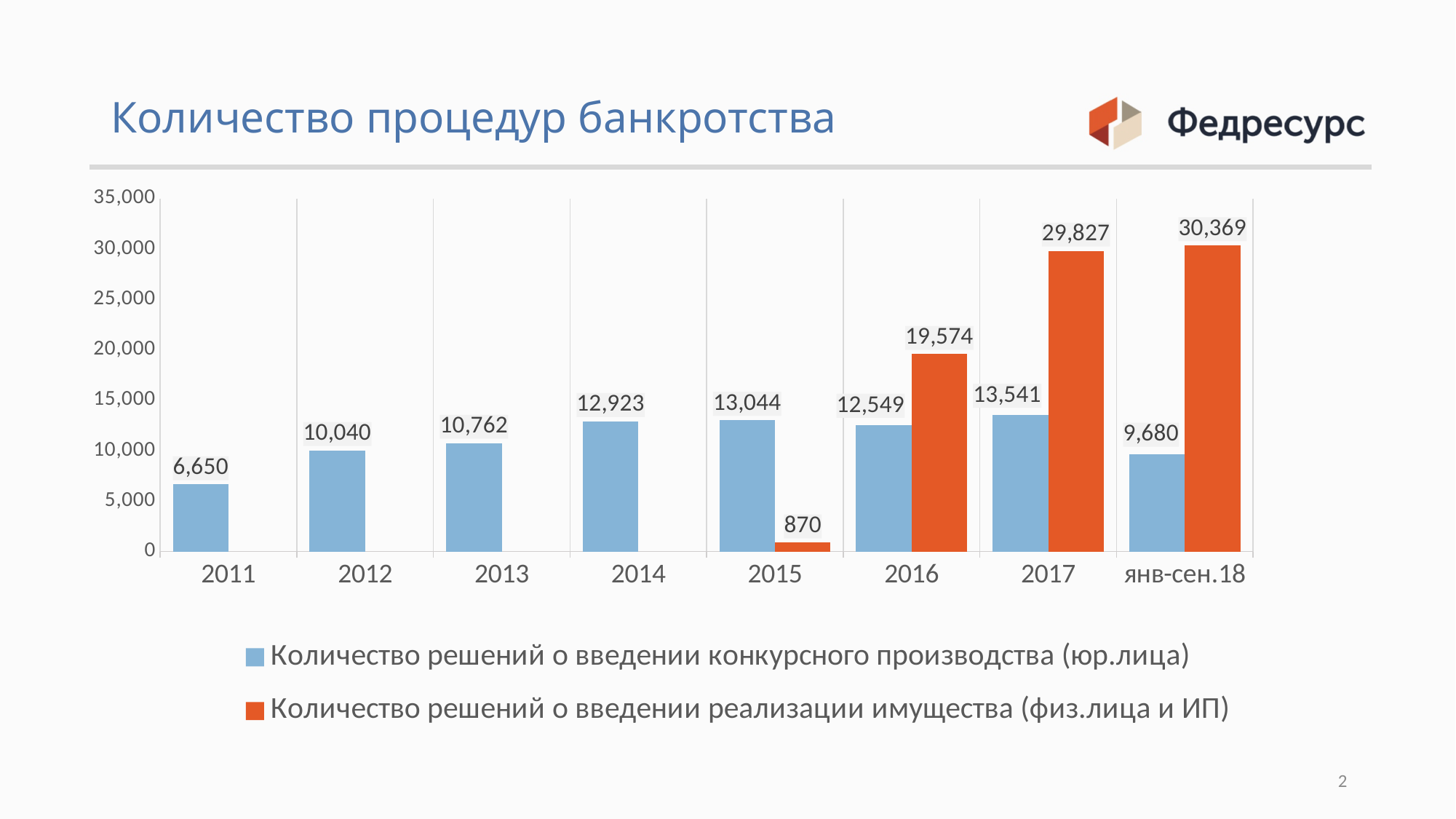
What is the value for 2014 in the series 'Количество решений о введении конкурсного производства (юр.лица)'? 12,923 How many series does the legend list? 2 How many categories are shown on the x axis? 8 What kind of chart is shown on the slide? bar chart What is the title of the slide? Количество процедур банкротства Which year has the highest value in the series 'Количество решений о введении конкурсного производства (юр.лица)'? 2017 What is the value for 2016 in the series 'Количество решений о введении реализации имущества (физ.лица и ИП)'? 19,574 Is the value for 2011 in the series 'Количество решений о введении конкурсного производства (юр.лица)' greater or less than 10,000? less What is the difference between the 2017 and 2016 values in the series 'Количество решений о введении реализации имущества (физ.лица и ИП)'? 10,253 Which category has the lowest value in the series 'Количество решений о введении реализации имущества (физ.лица и ИП)'? 2015 What is the value for янв-сен.18 in the series 'Количество решений о введении конкурсного производства (юр.лица)'? 9,680 In 2017, which series has the larger value: 'конкурсного производства (юр.лица)' or 'реализации имущества (физ.лица и ИП)'? Количество решений о введении реализации имущества (физ.лица и ИП)